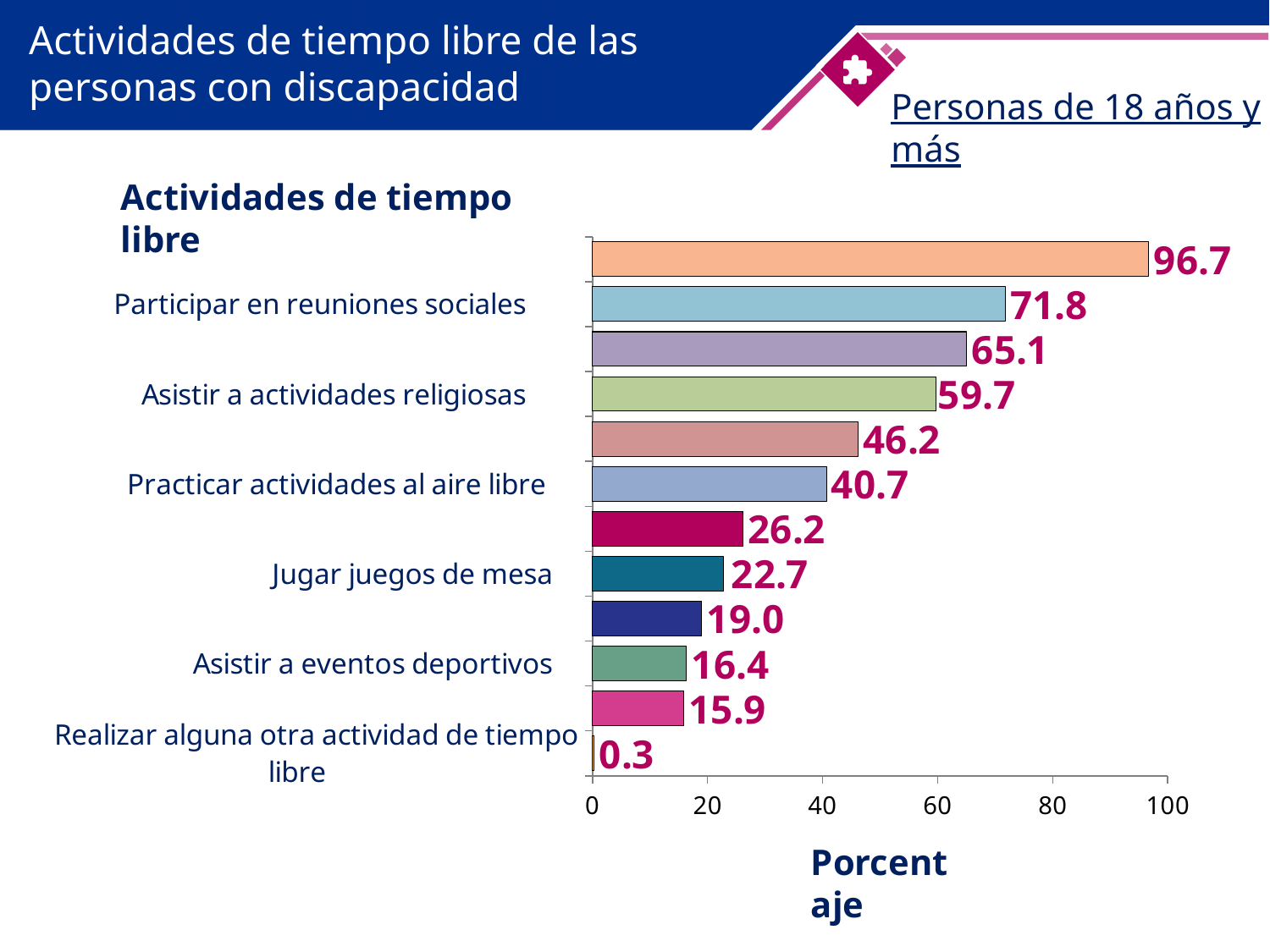
Which activity has the lowest value in the chart? Realizar alguna otra actividad de tiempo libre What is the value for 'Asistir a eventos deportivos'? 16.4 How many bars does the chart contain? 12 What is the value for 'Jugar juegos de mesa'? 22.7 What is the value for 'Practicar actividades al aire libre'? 40.7 What is the value for 'Asistir a actividades religiosas'? 59.7 What kind of chart is shown on the slide? bar chart What is the difference between the values for 'Participar en reuniones sociales' and 'Asistir a actividades religiosas'? 12.1 Which is larger, the value for 'Jugar juegos de mesa' or the value for 'Asistir a eventos deportivos'? Jugar juegos de mesa What is the value for 'Participar en reuniones sociales'? 71.8 What is the highest value shown in the chart? 96.7 What is the title of the horizontal axis of the chart? Porcentaje